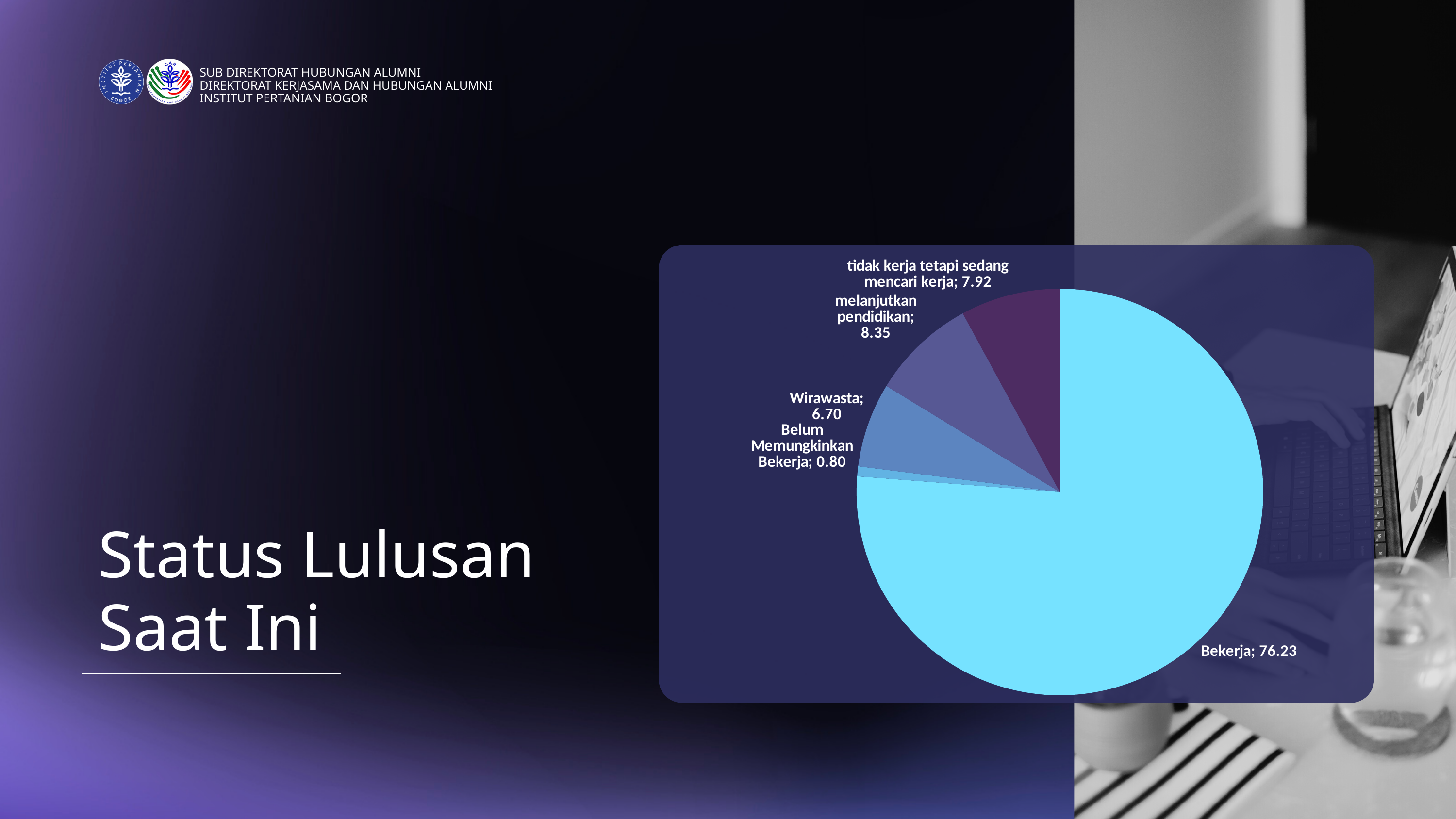
What is the value for Belum Memungkinkan Bekerja in the pie chart? 0.80 What is the difference between the values for Bekerja and melanjutkan pendidikan? 67.88 How many slices does the pie chart have? 5 Which category has the smallest slice in the pie chart? Belum Memungkinkan Bekerja What type of chart is shown on the slide? Pie chart Which is larger, the value for Wirawasta or the value for Belum Memungkinkan Bekerja? Wirawasta Which category has the largest slice in the pie chart? Bekerja What is the value for Bekerja in the pie chart? 76.23 What is the title of the slide containing the pie chart? Status Lulusan Saat Ini What is the value for melanjutkan pendidikan in the pie chart? 8.35 What is the value for tidak kerja tetapi sedang mencari kerja in the pie chart? 7.92 What is the value for Wirawasta in the pie chart? 6.70